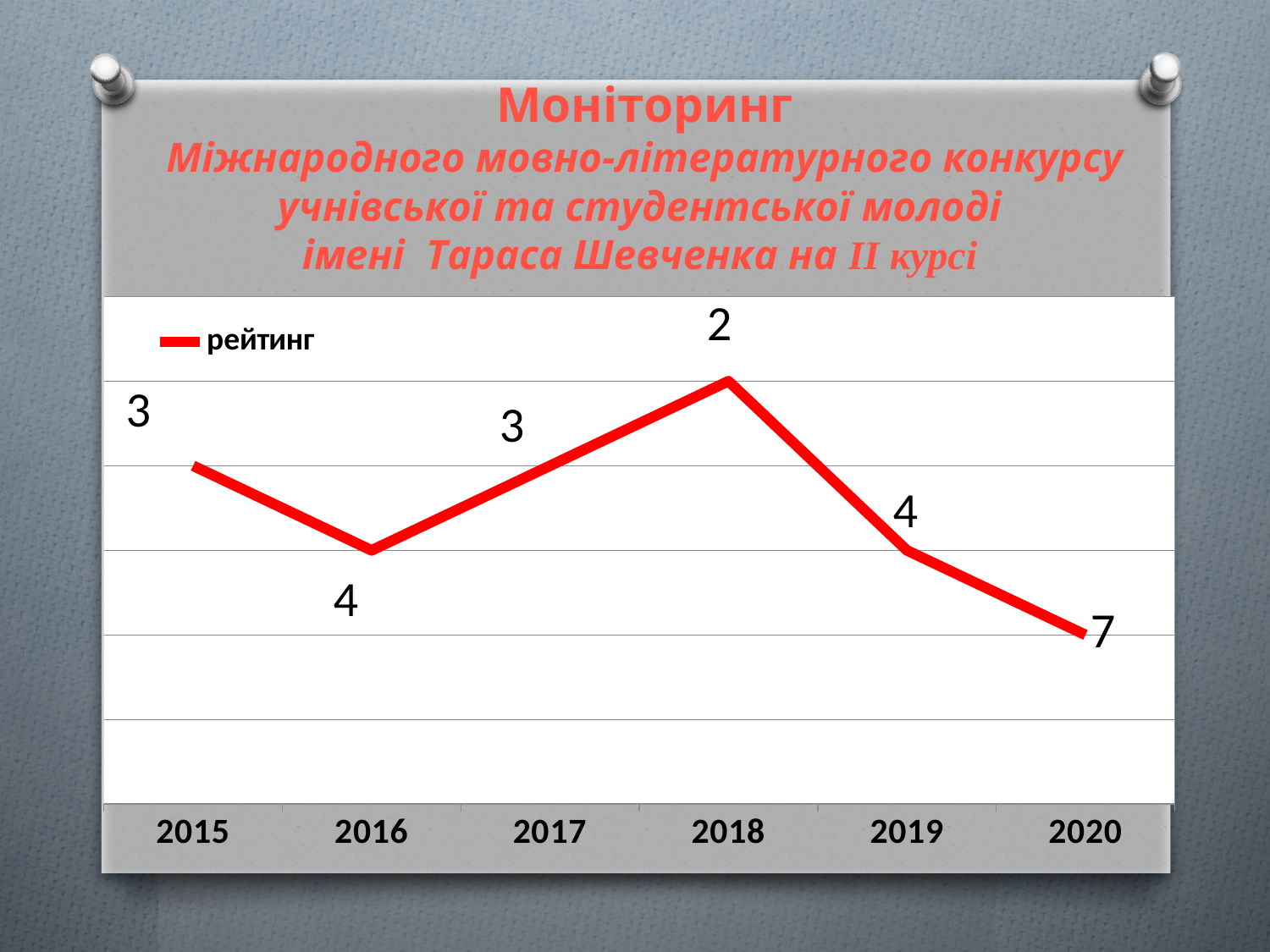
What is the difference between the values for 2020 and 2018? 5 How many series does the legend list? 1 What is the value for 2020? 7 What is the value for 2015? 3 What is the value for 2018? 2 What is the value for 2019? 4 What is the name of the series in the legend? рейтинг How many years are shown on the x axis? 6 What kind of chart is shown? line chart